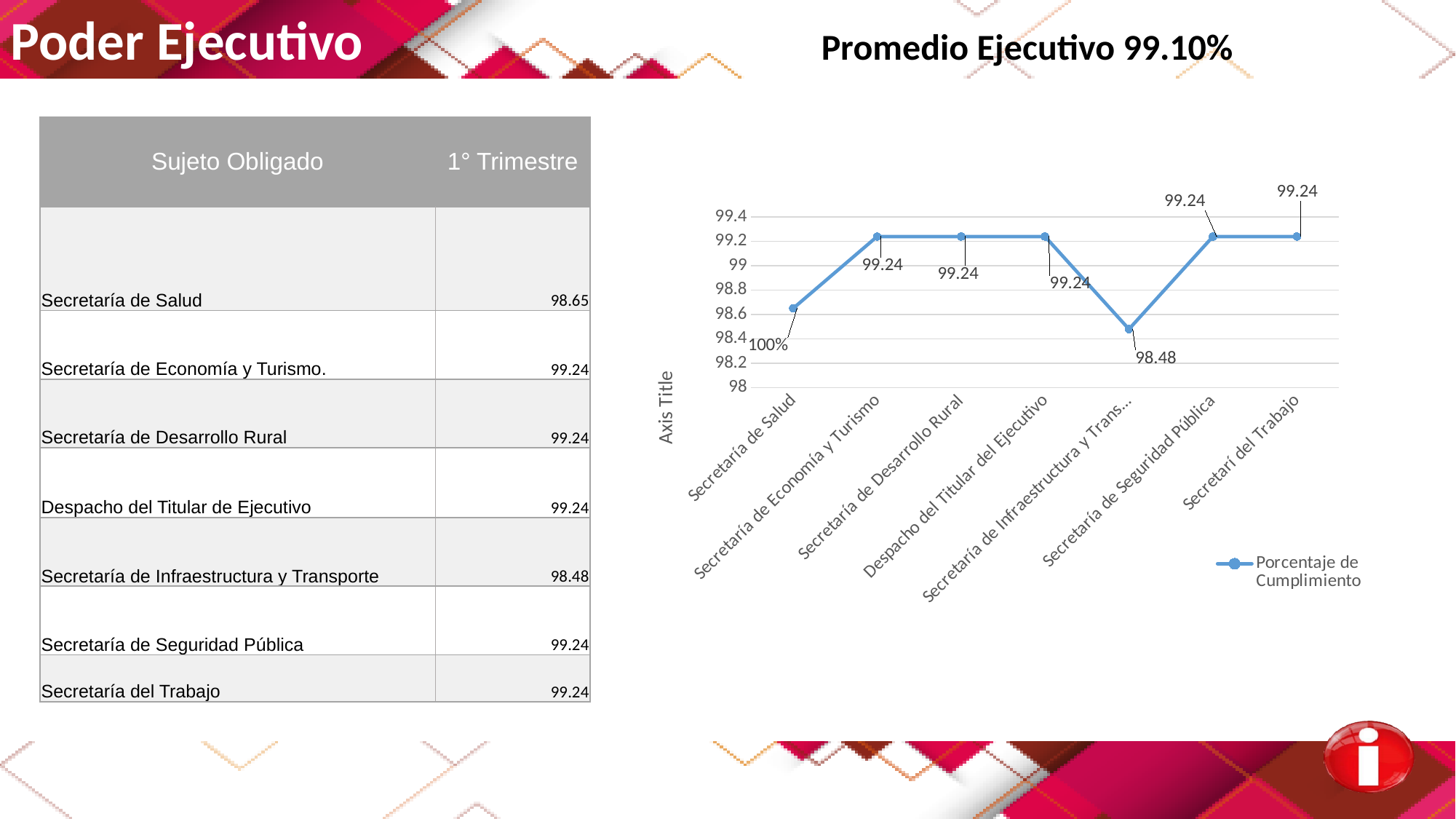
What is the value plotted for Secretaría de Infraestructura y Trans...? 98.48 What is the difference between the values for Secretaría de Seguridad Pública and Secretaría de Infraestructura y Trans...? 0.76 What is the value plotted for Secretaría de Seguridad Pública? 99.24 Is the value for Secretaría de Salud greater or less than 99? less Which category has the lowest value in the chart? Secretaría de Infraestructura y Trans... Does the line rise or fall from Despacho del Titular del Ejecutivo to Secretaría de Infraestructura y Trans...? fall What is the name of the series shown in the chart legend? Porcentaje de Cumplimiento Which has the larger value, Despacho del Titular del Ejecutivo or Secretaría de Infraestructura y Trans...? Despacho del Titular del Ejecutivo What kind of chart is shown on the slide? line chart How many categories are plotted along the x axis of the chart? 7 What is the value plotted for Secretaría de Economía y Turismo? 99.24 How many series does the chart legend list? 1